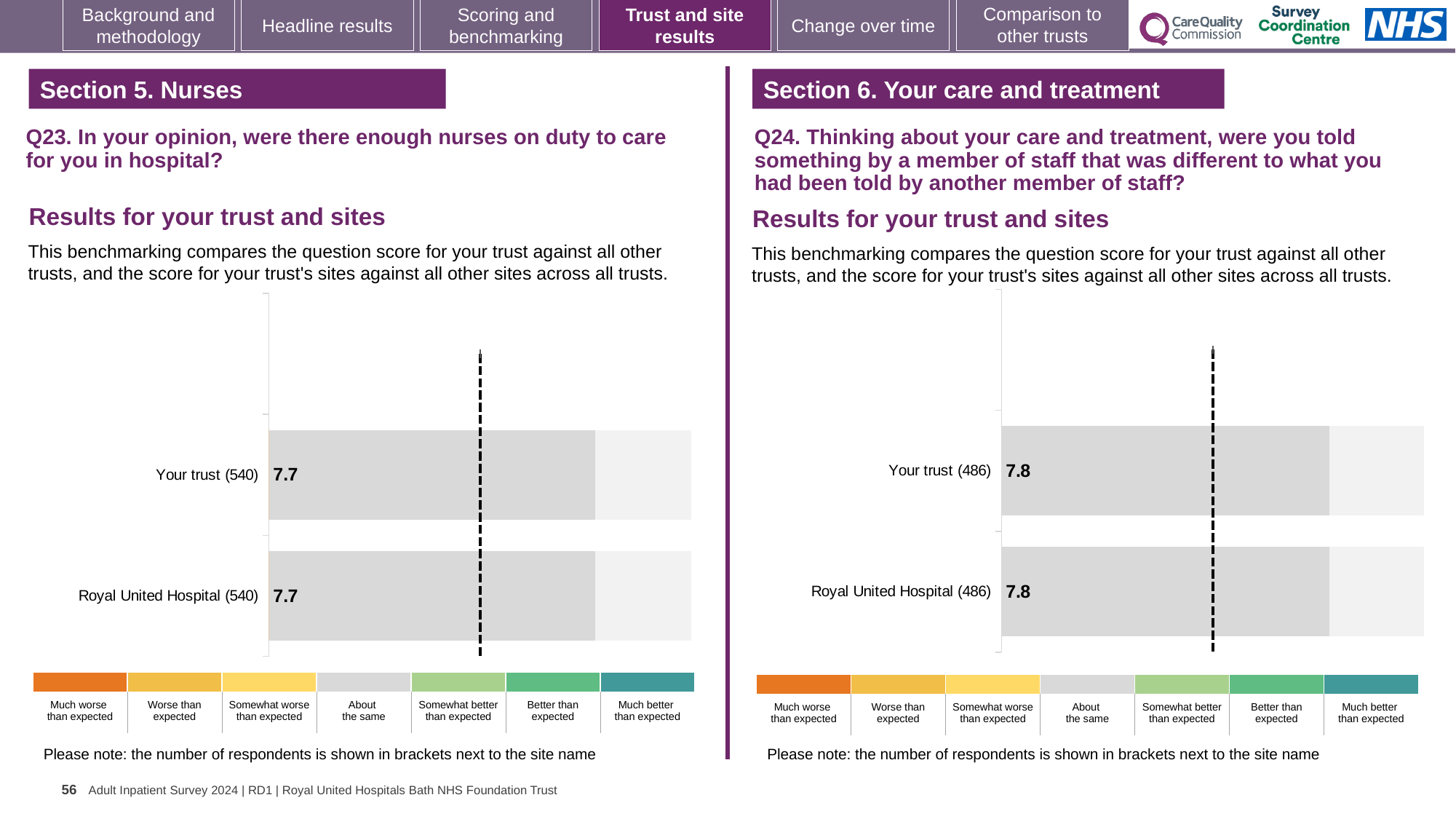
How many rating categories does the colour key below the Q23 chart on the left list? 7 In the Q23 chart on the left, what is the score for Your trust? 7.7 In the Q24 chart on the right, which rating category does the bar for Your trust fall into according to the colour key? About the same In the Q24 chart on the right, what is the score for Your trust? 7.8 In the Q24 chart on the right, what is the score for Royal United Hospital? 7.8 What is the difference between the Royal United Hospital score in the Q24 chart on the right and the Royal United Hospital score in the Q23 chart on the left? 0.1 In the Q23 chart on the left, what is the score for Royal United Hospital? 7.7 In the Q24 chart on the right, how many respondents are shown in brackets for Royal United Hospital? 486 In the Q23 chart on the left, how many respondents are shown in brackets for Your trust? 540 What kind of chart is the Q24 chart on the right? Bar chart How many bars are plotted in the Q23 chart on the left? 2 Which is larger: the Your trust score in the Q23 chart on the left or the Your trust score in the Q24 chart on the right? Q24 chart (7.8)